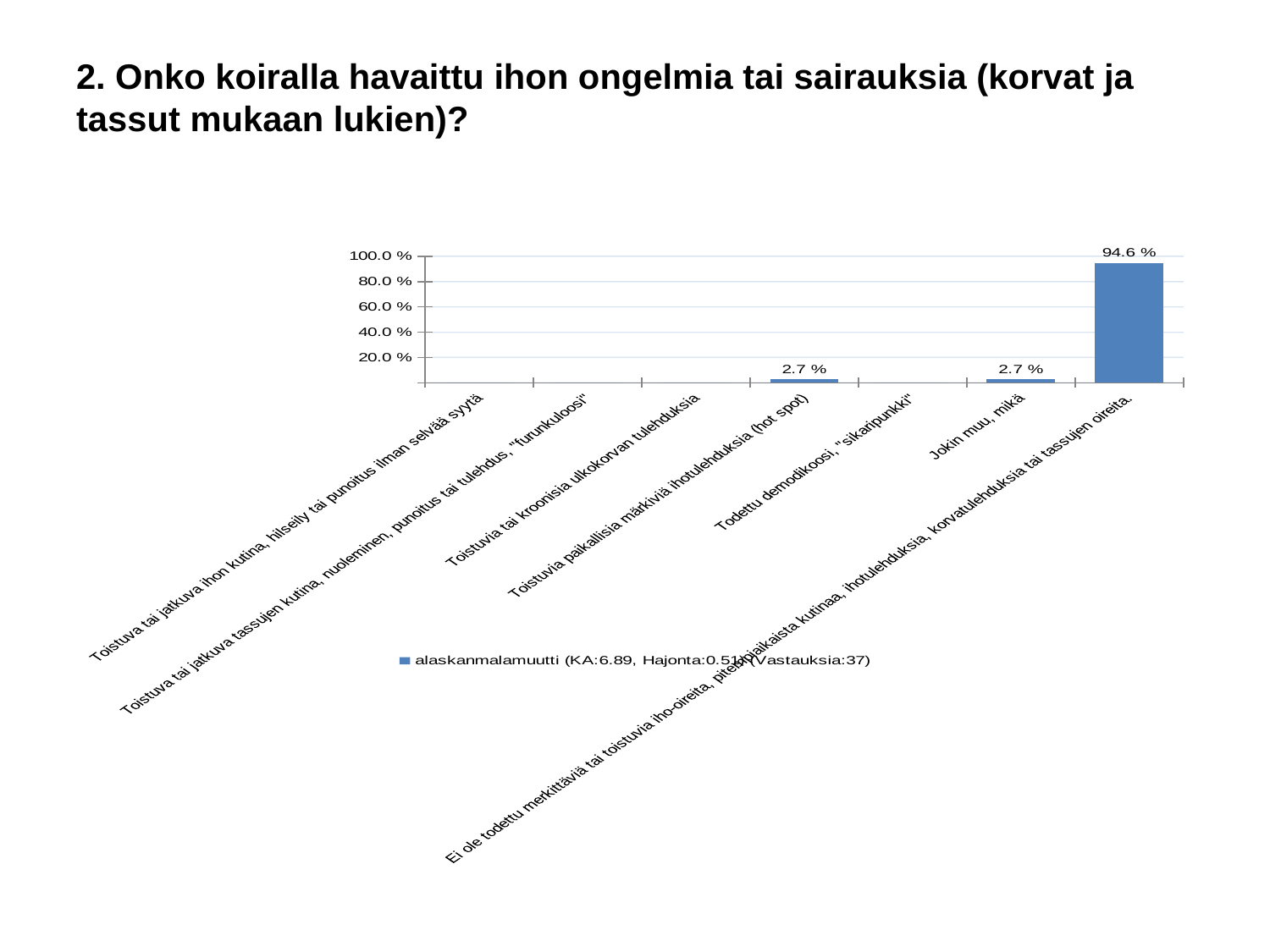
What is the highest value shown on the y axis? 100.0 % Is the value for the "Ei ole todettu..." category greater or less than 80.0 %? greater How many categories are shown on the x axis? 7 What is the value for "Toistuvia paikallisia märkiviä ihotulehduksia (hot spot)"? 2.7 % How many series does the legend list? 1 Which is larger: the value for "Jokin muu, mikä" or the value for the "Ei ole todettu..." category? Ei ole todettu... category What is the value shown on the tallest bar? 94.6 % What is the value for "Jokin muu, mikä"? 2.7 % What is the difference between the highest bar (94.6 %) and the bar for "Jokin muu, mikä" (2.7 %)? 91.9 % What kind of chart is shown on the slide? bar chart Is the value for "Jokin muu, mikä" greater or less than 20.0 %? less Which category has the highest value? Ei ole todettu merkittäviä tai toistuvia iho-oireita, pitempiaikaista kutinaa, ihotulehduksia, korvatulehduksia tai tassujen oireita.